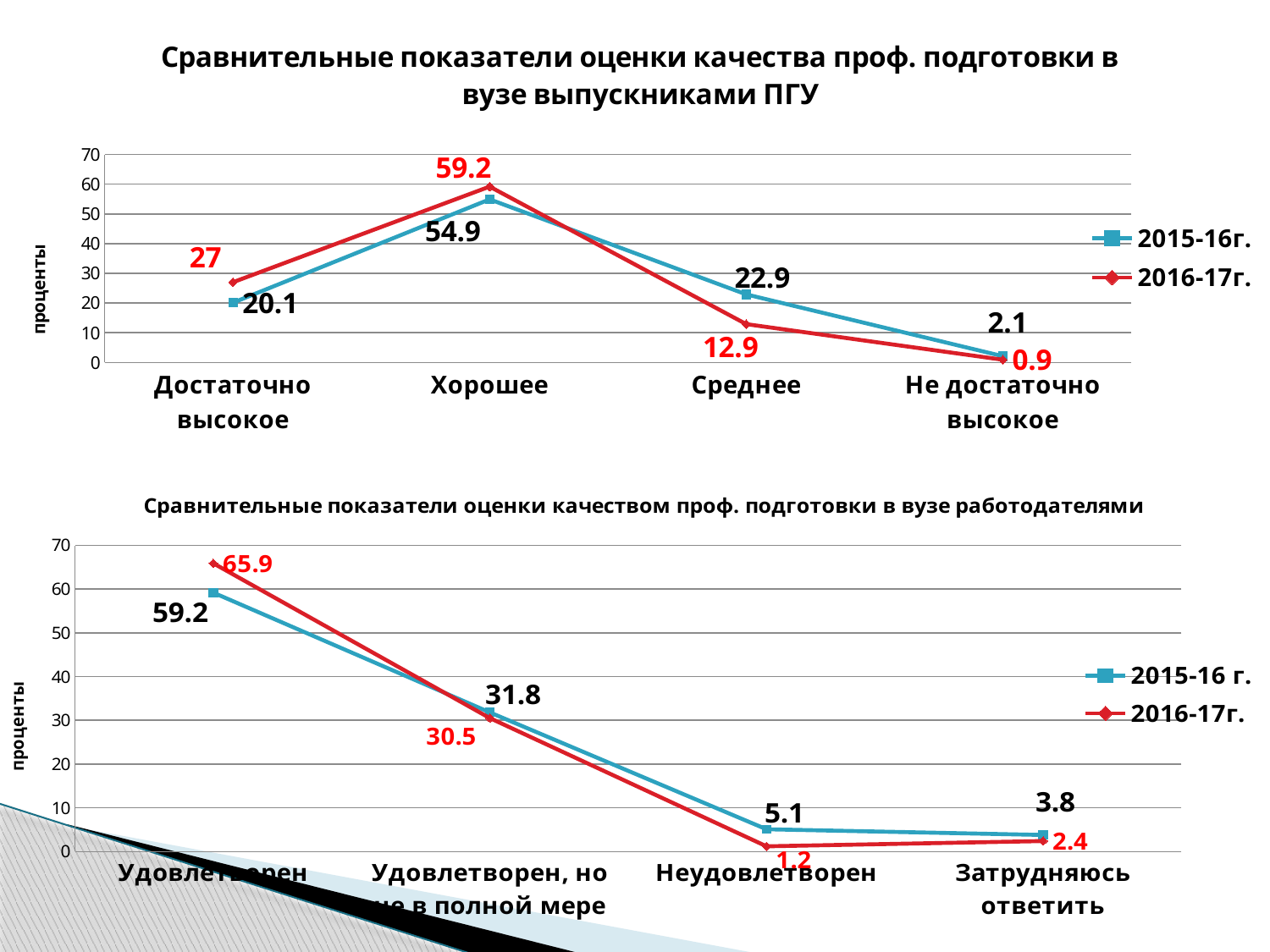
In the top chart (graduates' assessment), what is the value for 2016-17г. for the category Хорошее? 59.2 In the bottom chart (employers' assessment), what is the value for 2015-16 г. for the category Затрудняюсь ответить? 3.8 In the bottom chart (employers' assessment), do the values of the 2016-17г. series rise or fall from Удовлетворен to Неудовлетворен? fall In the bottom chart (employers' assessment), what is the difference between the 2015-16 г. and 2016-17г. values for Неудовлетворен? 3.9 In the top chart (graduates' assessment), what is the value for 2015-16г. for the category Среднее? 22.9 In the top chart (graduates' assessment), which series has the larger value for Среднее, 2015-16г. or 2016-17г.? 2015-16г. In the top chart (graduates' assessment), which category has the highest value for the 2015-16г. series? Хорошее In the bottom chart (employers' assessment), what is the value for 2016-17г. for the category Удовлетворен? 65.9 What type of chart is the bottom chart (employers' assessment)? line chart In the top chart (graduates' assessment), which category has the lowest value for the 2016-17г. series? Не достаточно высокое In the top chart (graduates' assessment), how many categories are shown on the x axis? 4 In the top chart (graduates' assessment), what is the difference between the 2016-17г. and 2015-16г. values for Достаточно высокое? 6.9